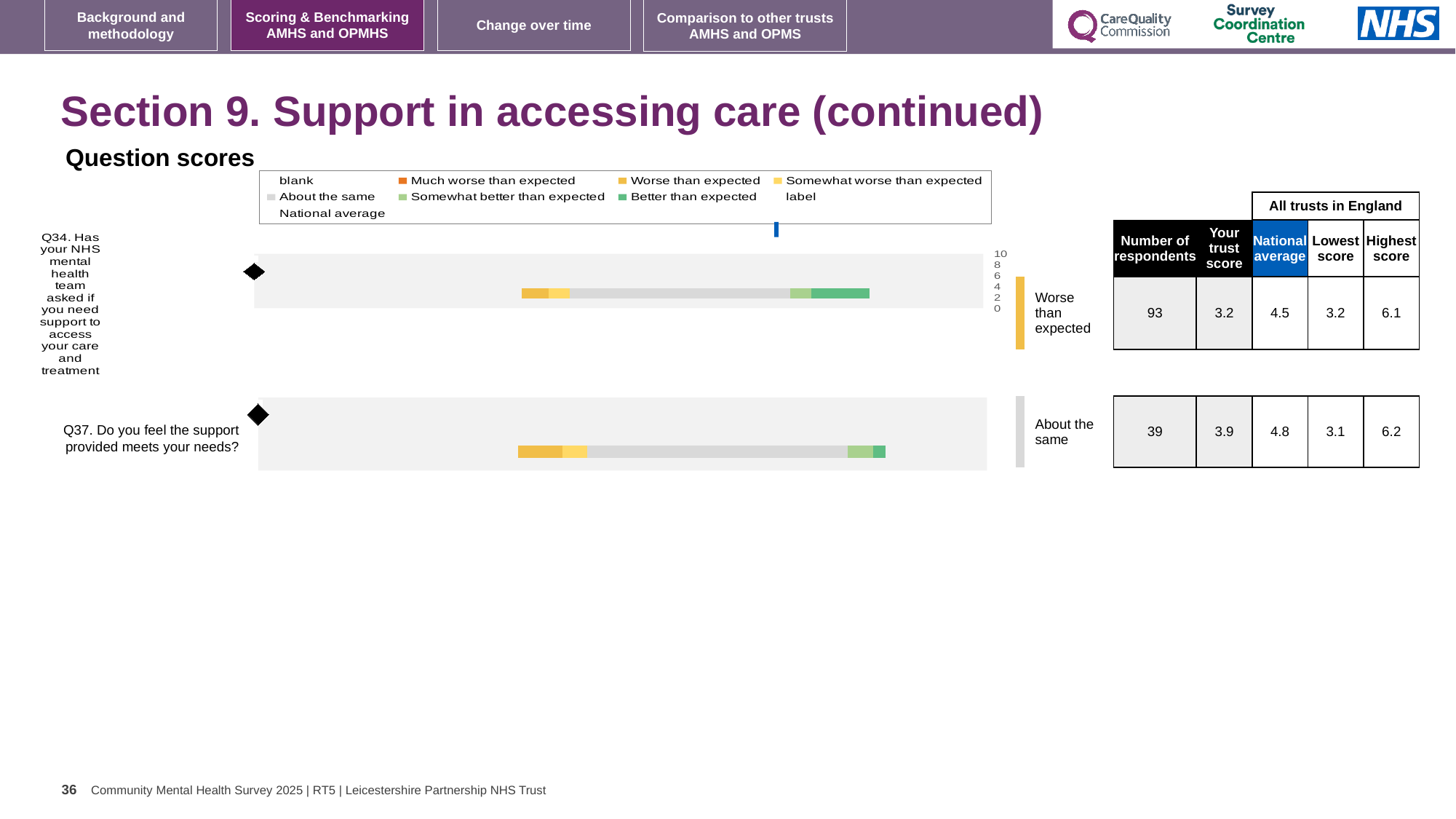
In the table beside the chart, what is the trust score for Q37? 3.9 In the table beside the chart, what is the difference between the national average and the trust score for Q34? 1.3 What colour does the legend use for 'Better than expected'? green In the table beside the chart, how many respondents answered Q34? 93 What kind of chart is used to show the question scores on this slide? bar chart Which benchmark category is shown for Q34 (Has your NHS mental health team asked if you need support to access your care and treatment)? Worse than expected How many entries does the legend of the question scores chart list? 9 How many questions (categories) are plotted in the question scores chart? 2 In the table beside the chart, what is the national average for Q37? 4.8 Which benchmark category is shown for Q37 (Do you feel the support provided meets your needs)? About the same In the table beside the chart, which question has the higher trust score, Q34 or Q37? Q37 In the table beside the chart, what is the trust score for Q34? 3.2